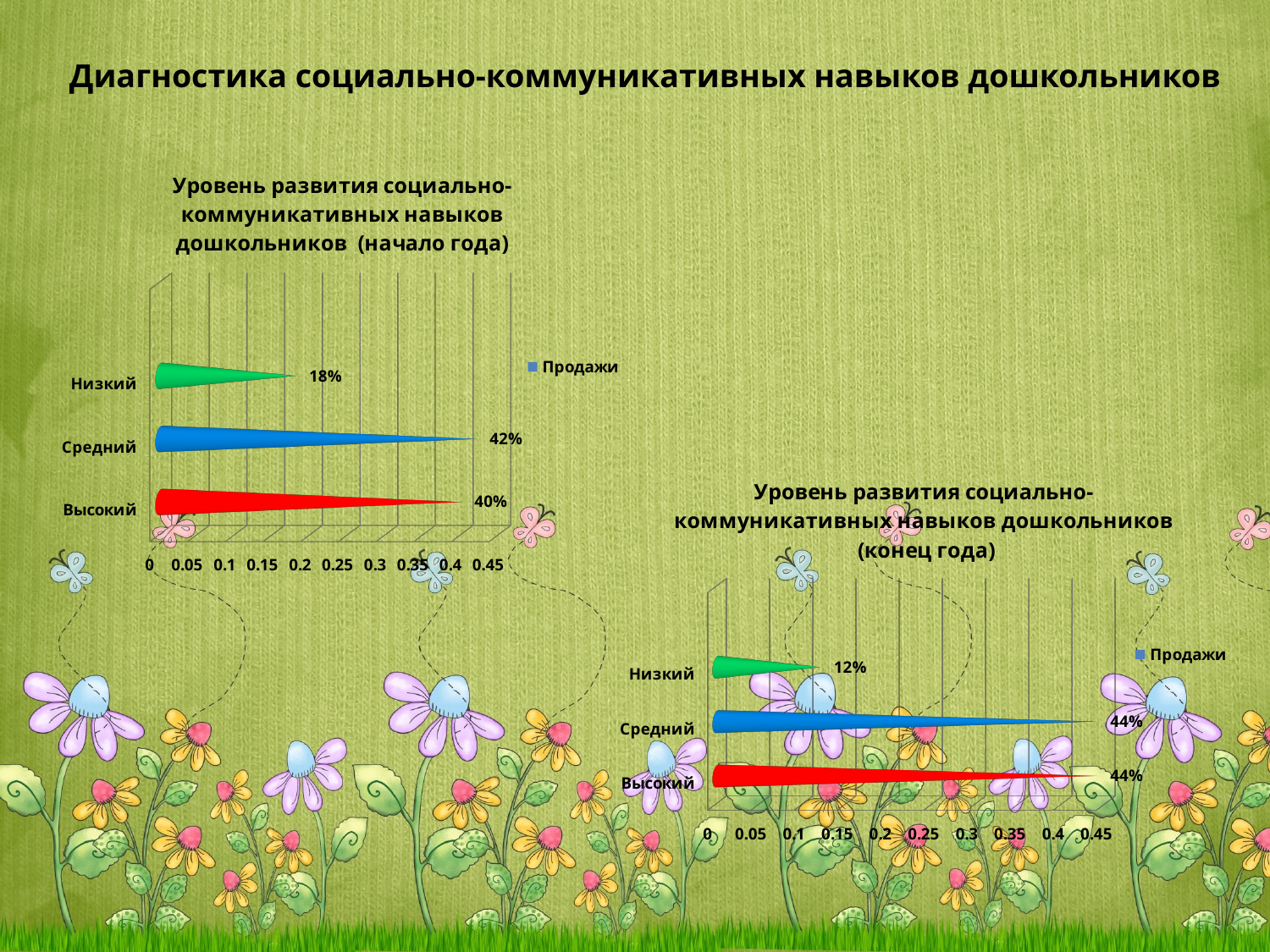
In the chart titled "Уровень развития социально-коммуникативных навыков дошкольников (конец года)", what is the value for Высокий? 44% What kind of chart is the chart titled "Уровень развития социально-коммуникативных навыков дошкольников (начало года)"? Bar chart In the chart titled "Уровень развития социально-коммуникативных навыков дошкольников (начало года)", which is larger, the value for Высокий or the value for Низкий? Высокий In the chart titled "Уровень развития социально-коммуникативных навыков дошкольников (конец года)", what is the difference between the values for Средний and Низкий? 32% In the chart titled "Уровень развития социально-коммуникативных навыков дошкольников (начало года)", which category has the highest value? Средний In the chart titled "Уровень развития социально-коммуникативных навыков дошкольников (начало года)", what is the difference between the values for Средний and Низкий? 24% In the chart titled "Уровень развития социально-коммуникативных навыков дошкольников (конец года)", which category has the lowest value? Низкий In the chart titled "Уровень развития социально-коммуникативных навыков дошкольников (начало года)", what is the value for Низкий? 18% In the chart titled "Уровень развития социально-коммуникативных навыков дошкольников (конец года)", what is the value for Низкий? 12% In the chart titled "Уровень развития социально-коммуникативных навыков дошкольников (начало года)", what is the value for Средний? 42% How many series does the legend list in the chart titled "Уровень развития социально-коммуникативных навыков дошкольников (конец года)"? 1 How many categories are shown in the chart titled "Уровень развития социально-коммуникативных навыков дошкольников (конец года)"? 3